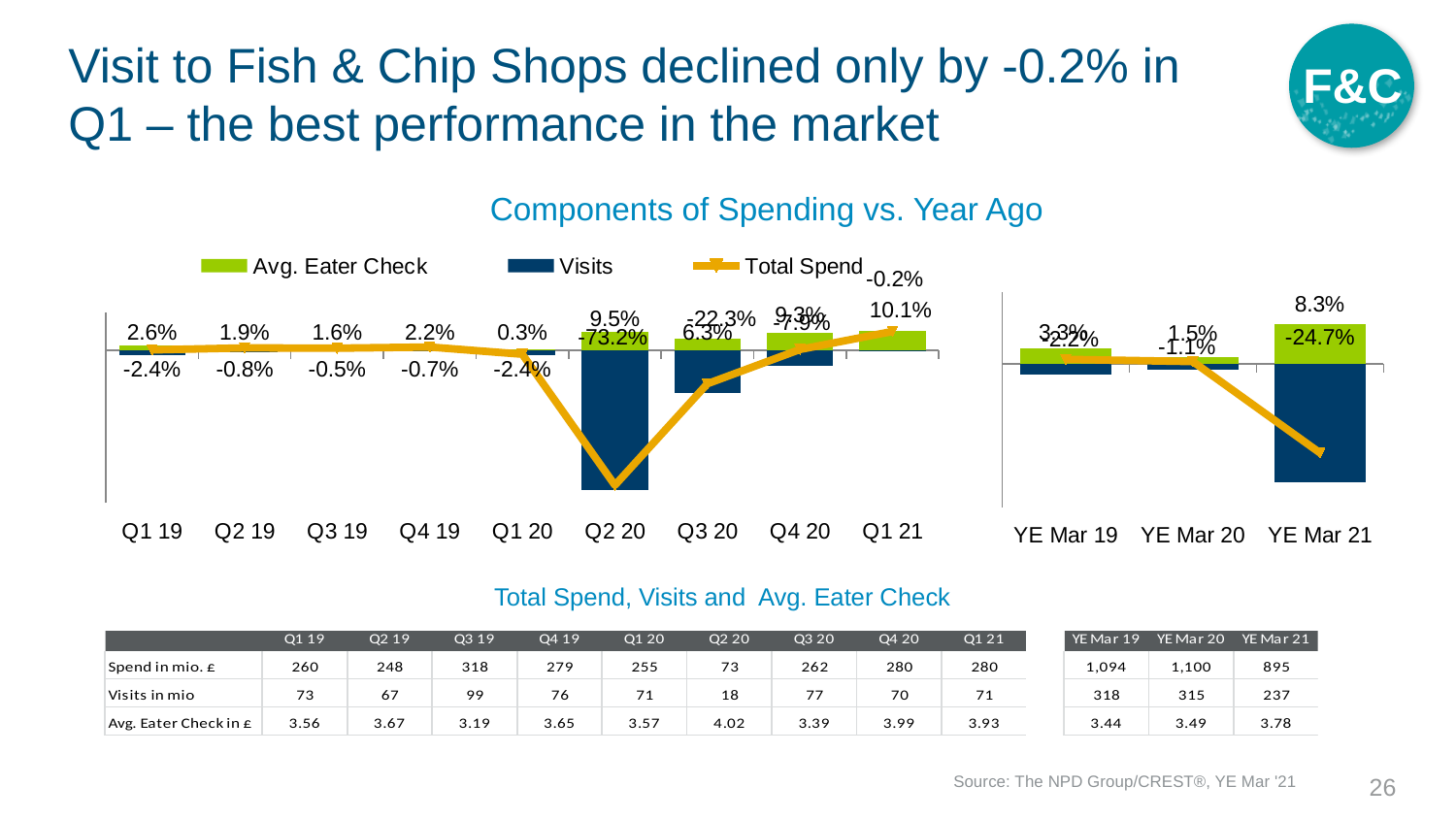
In the quarterly 'Components of Spending vs. Year Ago' chart, what is the Visits value for Q2 20? -73.2% Which series in the 'Components of Spending vs. Year Ago' chart is drawn as a line rather than bars? Total Spend In the yearly chart on the right (YE Mar 19 to YE Mar 21), what is the Visits value for YE Mar 21? -24.7% In the quarterly 'Components of Spending vs. Year Ago' chart, which quarter has the highest Avg. Eater Check value? Q1 21 In the quarterly 'Components of Spending vs. Year Ago' chart, what is the Visits value for Q1 21? -0.2% In the yearly chart on the right (YE Mar 19 to YE Mar 21), what is the Avg. Eater Check value for YE Mar 21? 8.3% In the quarterly 'Components of Spending vs. Year Ago' chart, is the Avg. Eater Check value for Q2 20 larger or smaller than the value for Q1 20? larger In the quarterly 'Components of Spending vs. Year Ago' chart, what is the Avg. Eater Check value for Q1 19? 2.6% In the quarterly 'Components of Spending vs. Year Ago' chart, which quarter has the lowest Visits value? Q2 20 How many series does the legend of the 'Components of Spending vs. Year Ago' chart list? 3 In the quarterly 'Components of Spending vs. Year Ago' chart, how many quarters are shown on the x axis? 9 In the quarterly 'Components of Spending vs. Year Ago' chart, what is the Avg. Eater Check value for Q1 21? 10.1%